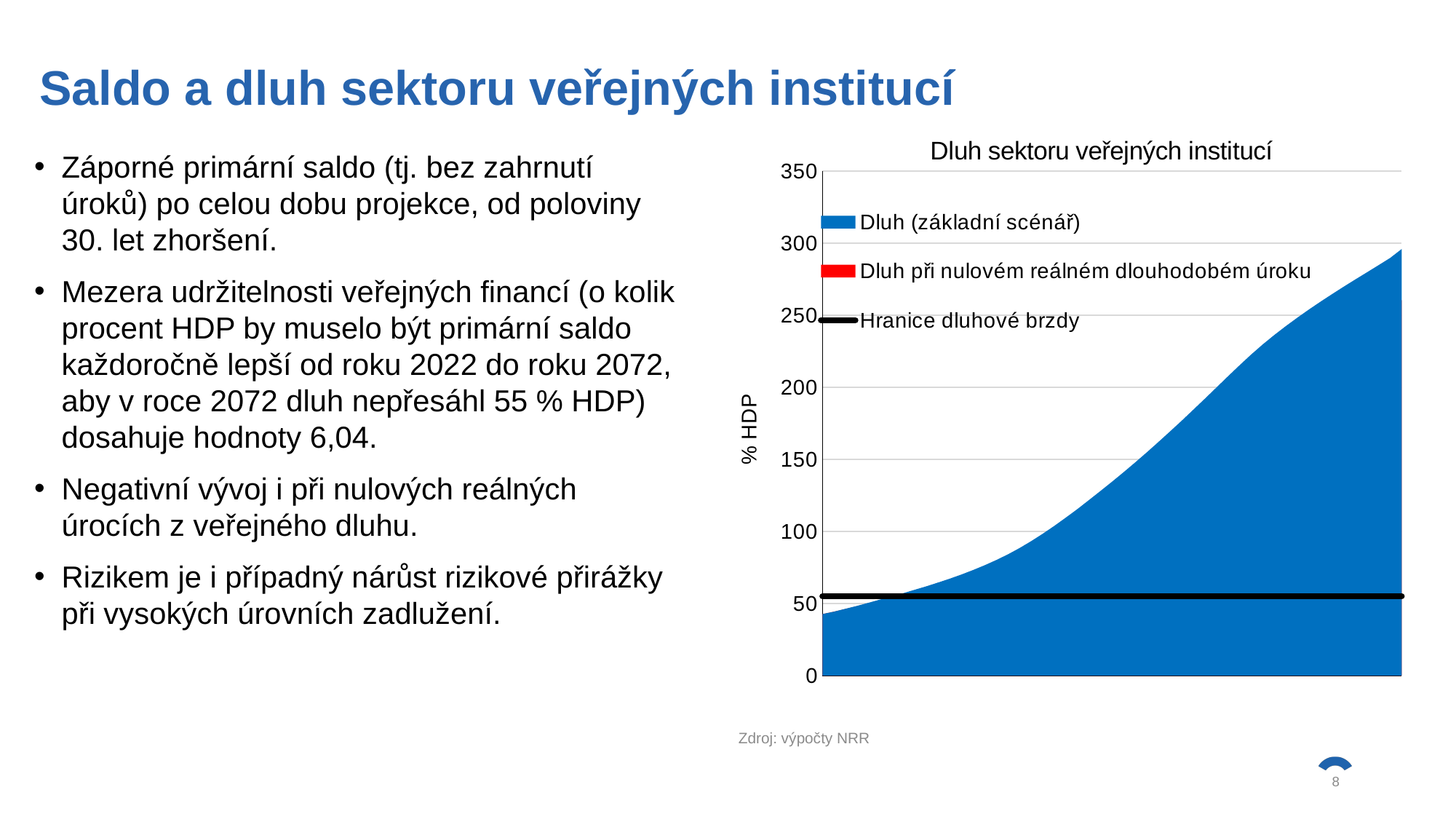
At the right end of the chart, which is larger: Dluh (základní scénář) or Hranice dluhové brzdy? Dluh (základní scénář) Is the value of Hranice dluhové brzdy greater or less than 100? less Does the value of Dluh (základní scénář) rise or fall along the x axis? rise Is the value of Dluh (základní scénář) at the right end of the chart greater or less than 250? greater What kind of chart is shown on the slide? area chart What is the title of the chart? Dluh sektoru veřejných institucí Is the value of Hranice dluhové brzdy greater or less than 50? greater How many series does the legend of the chart list? 3 What is the highest value shown on the y axis of the chart? 350